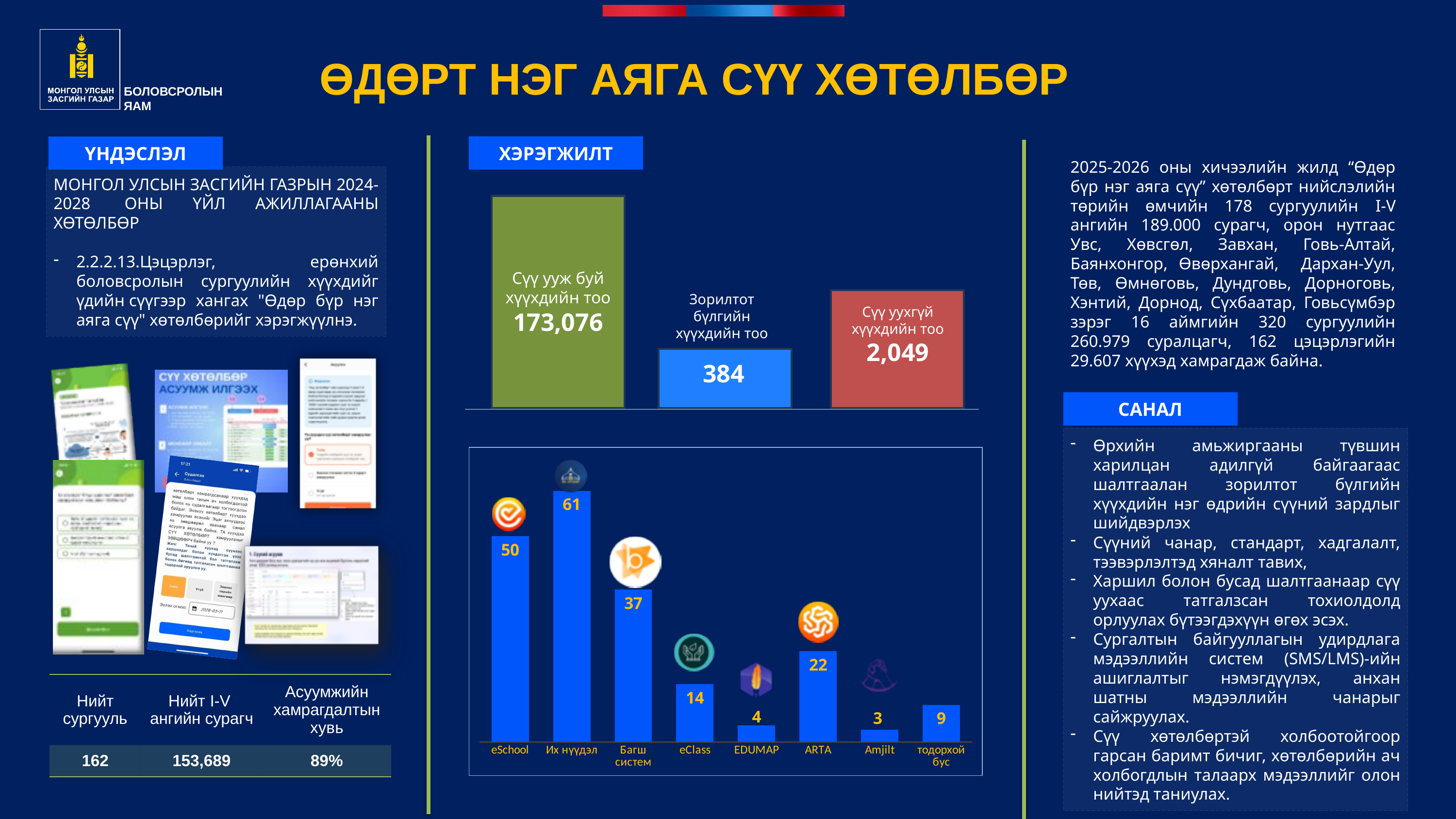
In the upper chart, which category has the lowest value? Зорилтот бүлгийн хүүхдийн тоо In the lower bar chart, what is the value for ARTA? 22 In the lower bar chart, which is larger, the value for eClass or the value for тодорхой бус? eClass In the lower bar chart, what is the difference between the values for Их нүүдэл and eSchool? 11 In the upper chart, what is the value for Сүү уухгүй хүүхдийн тоо? 2,049 In the lower bar chart, what is the value for Багш систем? 37 In the lower bar chart, which category has the highest value? Их нүүдэл In the lower bar chart, what is the value for eSchool? 50 In the upper chart, what is the value for Сүү ууж буй хүүхдийн тоо? 173,076 What kind of chart is the lower chart on the slide? bar chart In the lower bar chart, which category has the lowest value? Amjilt How many categories are shown in the lower bar chart? 8